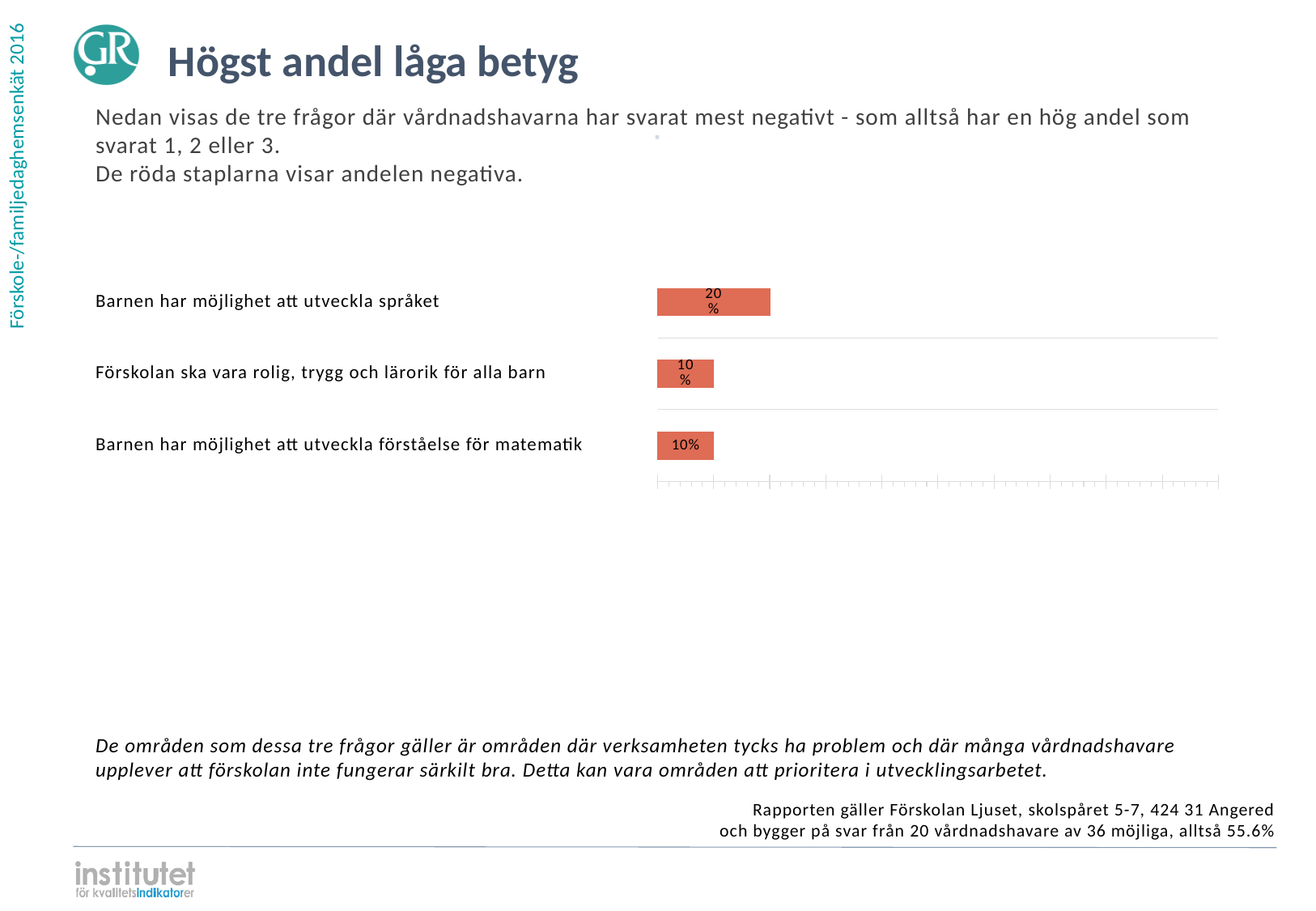
What kind of chart is shown on the slide? Bar chart What colour are the bars in the chart? Red Which category has the highest value? Barnen har möjlighet att utveckla språket What is the value for "Barnen har möjlighet att utveckla förståelse för matematik"? 10% How many categories are shown in the chart? 3 What is the value for "Förskolan ska vara rolig, trygg och lärorik för alla barn"? 10% Which is larger: the value for "Barnen har möjlighet att utveckla språket" or the value for "Barnen har möjlighet att utveckla förståelse för matematik"? Barnen har möjlighet att utveckla språket Do the values for "Förskolan ska vara rolig, trygg och lärorik för alla barn" and "Barnen har möjlighet att utveckla förståelse för matematik" have the same value? Yes What is the value for "Barnen har möjlighet att utveckla språket"? 20% What is the title of the slide containing the chart? Högst andel låga betyg What is the difference between the value for "Barnen har möjlighet att utveckla språket" and the value for "Förskolan ska vara rolig, trygg och lärorik för alla barn"? 10%